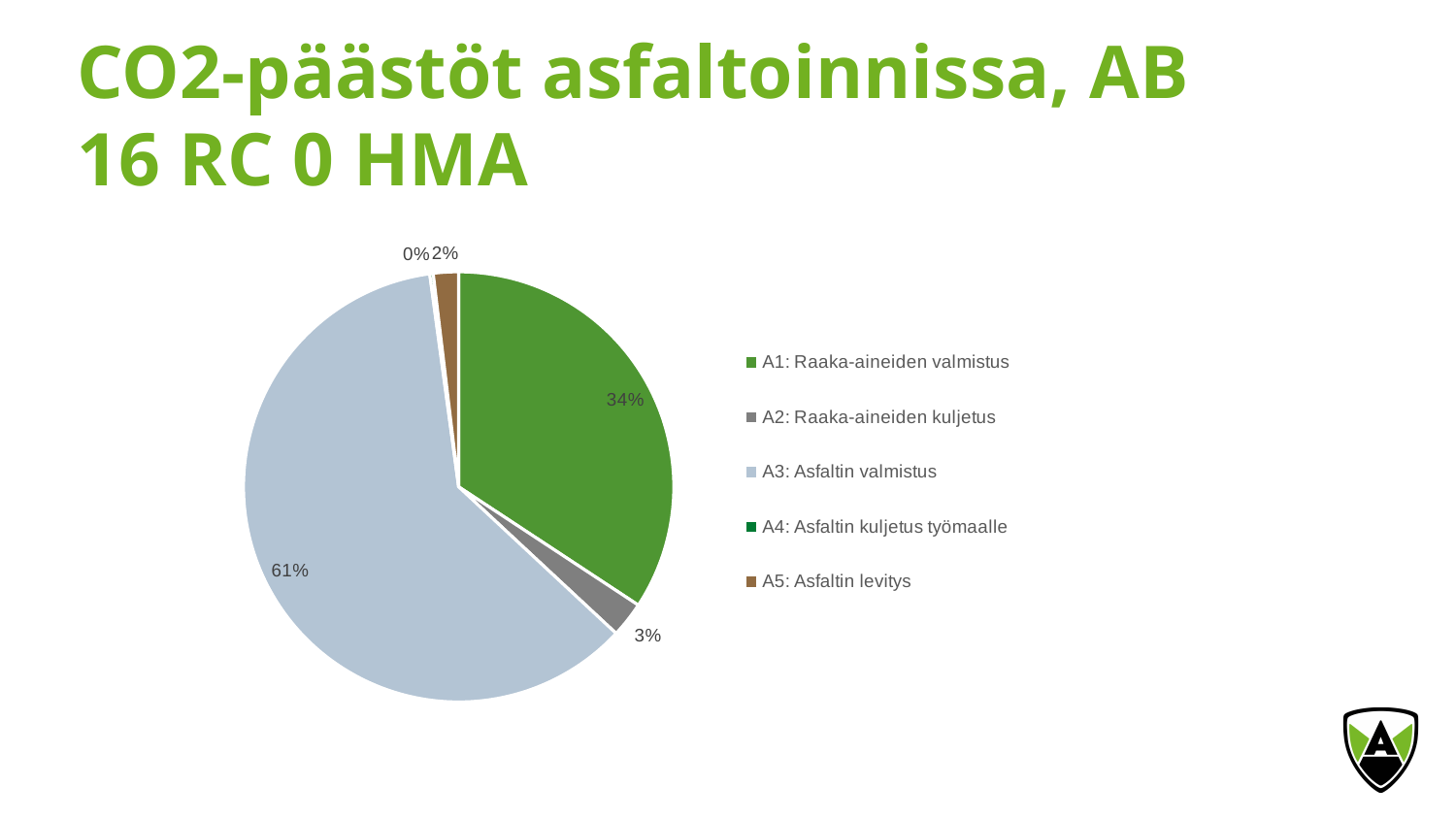
What is the difference in percentage points between A3: Asfaltin valmistus and A1: Raaka-aineiden valmistus? 27 percentage points What is the value shown for A5: Asfaltin levitys? 2% What is the title of the slide? CO2-päästöt asfaltoinnissa, AB 16 RC 0 HMA How many categories does the legend list? 5 What share of the pie does A3: Asfaltin valmistus account for? 61% What is the value shown for A4: Asfaltin kuljetus työmaalle? 0% Which category has the largest share of the pie? A3: Asfaltin valmistus Which category has the smallest share of the pie? A4: Asfaltin kuljetus työmaalle Which is larger, the share for A2: Raaka-aineiden kuljetus or the share for A5: Asfaltin levitys? A2: Raaka-aineiden kuljetus What is the value shown for A2: Raaka-aineiden kuljetus? 3% What kind of chart is shown on the slide? Pie chart What share of the pie does A1: Raaka-aineiden valmistus account for? 34%